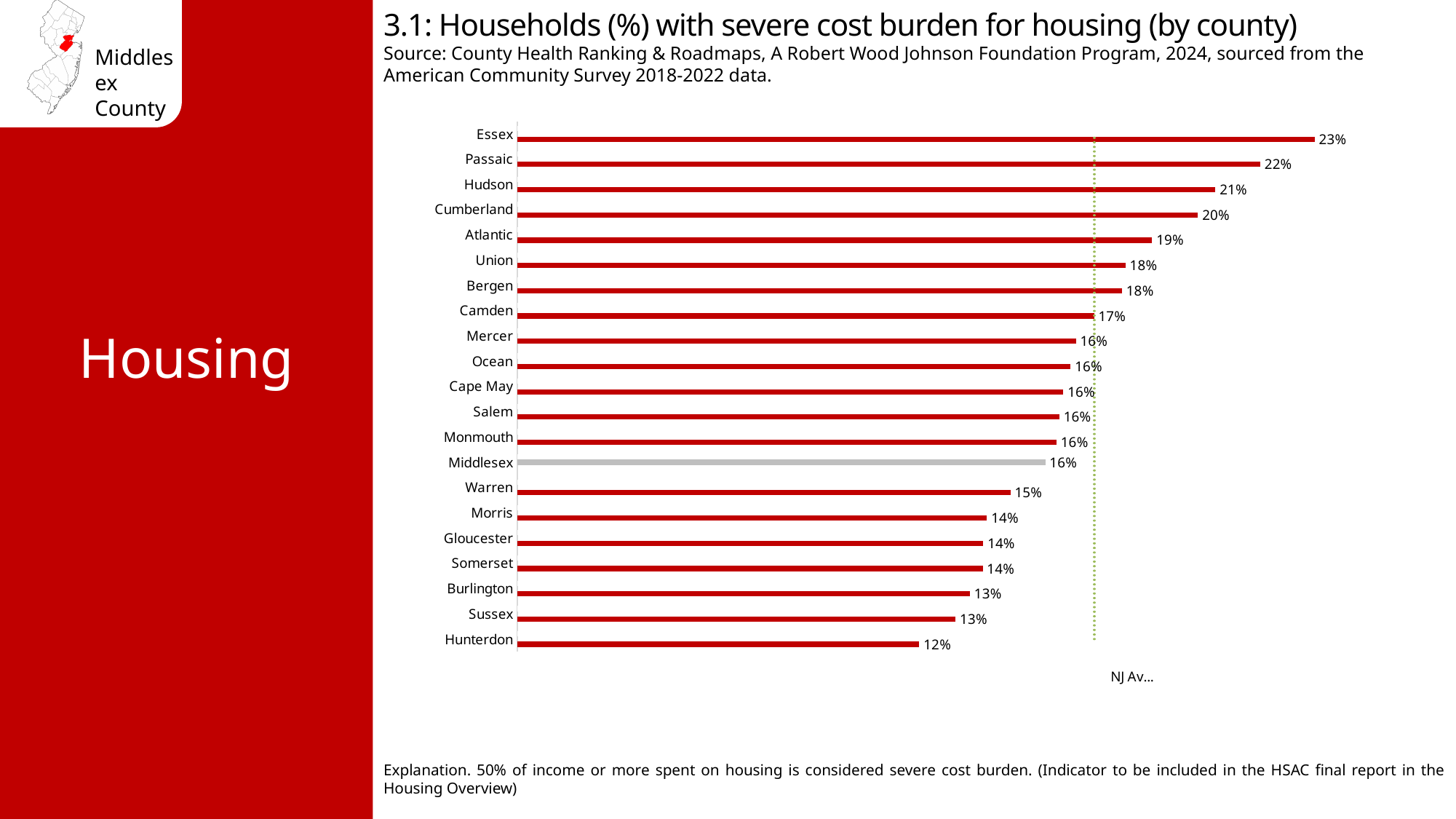
Which county has the lowest percentage of households with severe housing cost burden? Hunterdon How many counties are plotted in the chart? 21 What percentage is shown for Hunterdon County? 12% What is the value shown for Middlesex County? 16% What is the difference between the values for Essex and Hunterdon? 11% What is the difference between the values for Passaic and Middlesex? 6% Which county's bar is drawn in grey instead of red? Middlesex Which has a higher value, Hudson or Atlantic? Hudson What percentage of households in Essex County have a severe housing cost burden? 23% What kind of chart is shown on the slide? Bar chart Which has a higher value, Warren or Sussex? Warren Which county has the highest percentage of households with severe housing cost burden? Essex